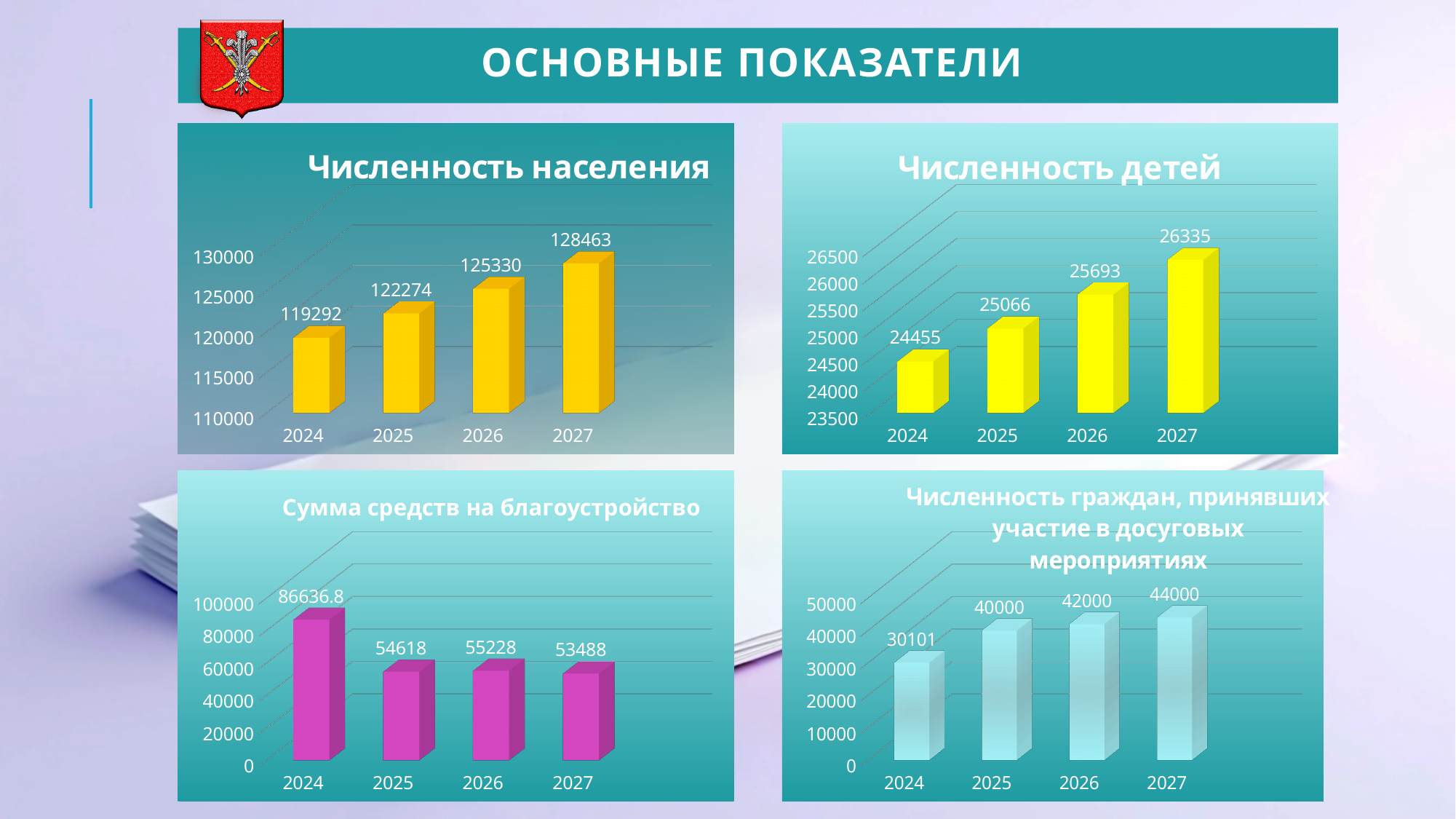
In the 'Численность детей' chart, what is the value for 2025? 25066 In the 'Сумма средств на благоустройство' chart, which year has the highest value? 2024 In the 'Численность населения' chart, which year has the lowest value? 2024 In the 'Численность граждан, принявших участие в досуговых мероприятиях' chart, what is the value for 2024? 30101 In the 'Численность детей' chart, do the values rise or fall from 2024 to 2027? rise In the 'Численность граждан, принявших участие в досуговых мероприятиях' chart, what is the difference between the 2027 and 2025 values? 4000 In the 'Сумма средств на благоустройство' chart, what is the value for 2024? 86636.8 In the 'Численность населения' chart, what is the value for 2027? 128463 In the 'Сумма средств на благоустройство' chart, which is larger, the value for 2026 or the value for 2027? 2026 In the 'Численность населения' chart, what is the difference between the 2027 and 2024 values? 9171 What kind of chart is the 'Численность граждан, принявших участие в досуговых мероприятиях' chart? bar chart In the 'Численность детей' chart, how many years are shown on the x axis? 4